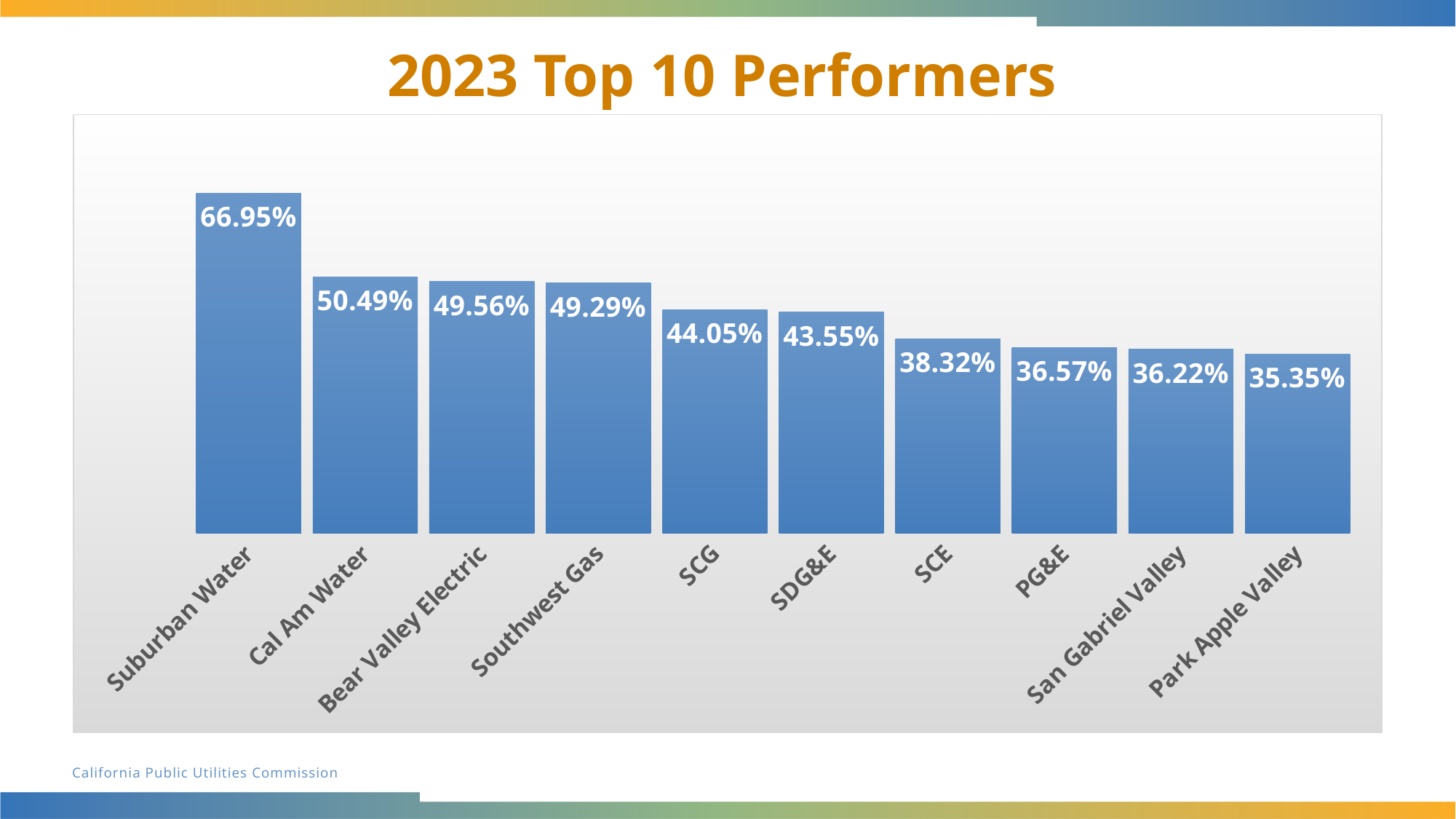
What is the value for Suburban Water? 66.95% How many categories are shown in the chart? 10 Which is larger, the value for Southwest Gas or the value for PG&E? Southwest Gas Do the values rise or fall from left to right along the x axis? Fall Which category has the lowest value? Park Apple Valley What kind of chart is shown on the slide? Bar chart What is the difference between the values for Suburban Water and Cal Am Water? 16.46% What is the value for SDG&E? 43.55% What is the difference between the values for SCG and SCE? 5.73% What is the title of the slide? 2023 Top 10 Performers What is the value for San Gabriel Valley? 36.22% Which category has the highest value? Suburban Water